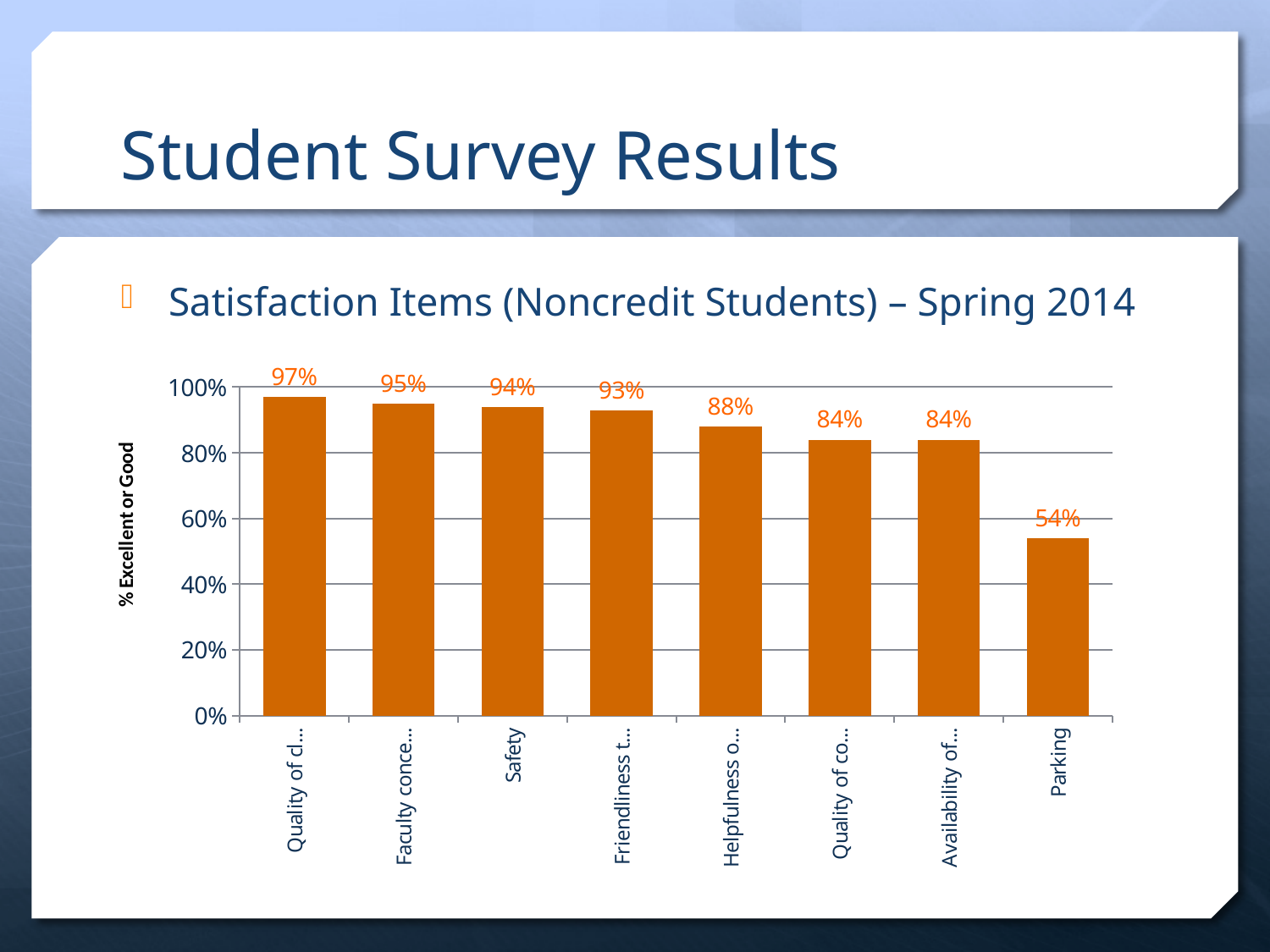
How many categories (bars) are shown on the chart? 8 What is the value of the first (leftmost) bar? 97% What is the highest value shown on the chart? 97% What is the value for Parking? 54% What is the difference between the values for Safety and Parking? 40% What is the value for Safety? 94% Is the value for Parking greater or less than 60%? less What kind of chart is shown on the slide? bar chart Do the values generally rise or fall from left to right along the x axis? fall What is the label of the vertical axis? % Excellent or Good Which is larger, the value for Safety or the value for Parking? Safety Which category has the lowest value? Parking